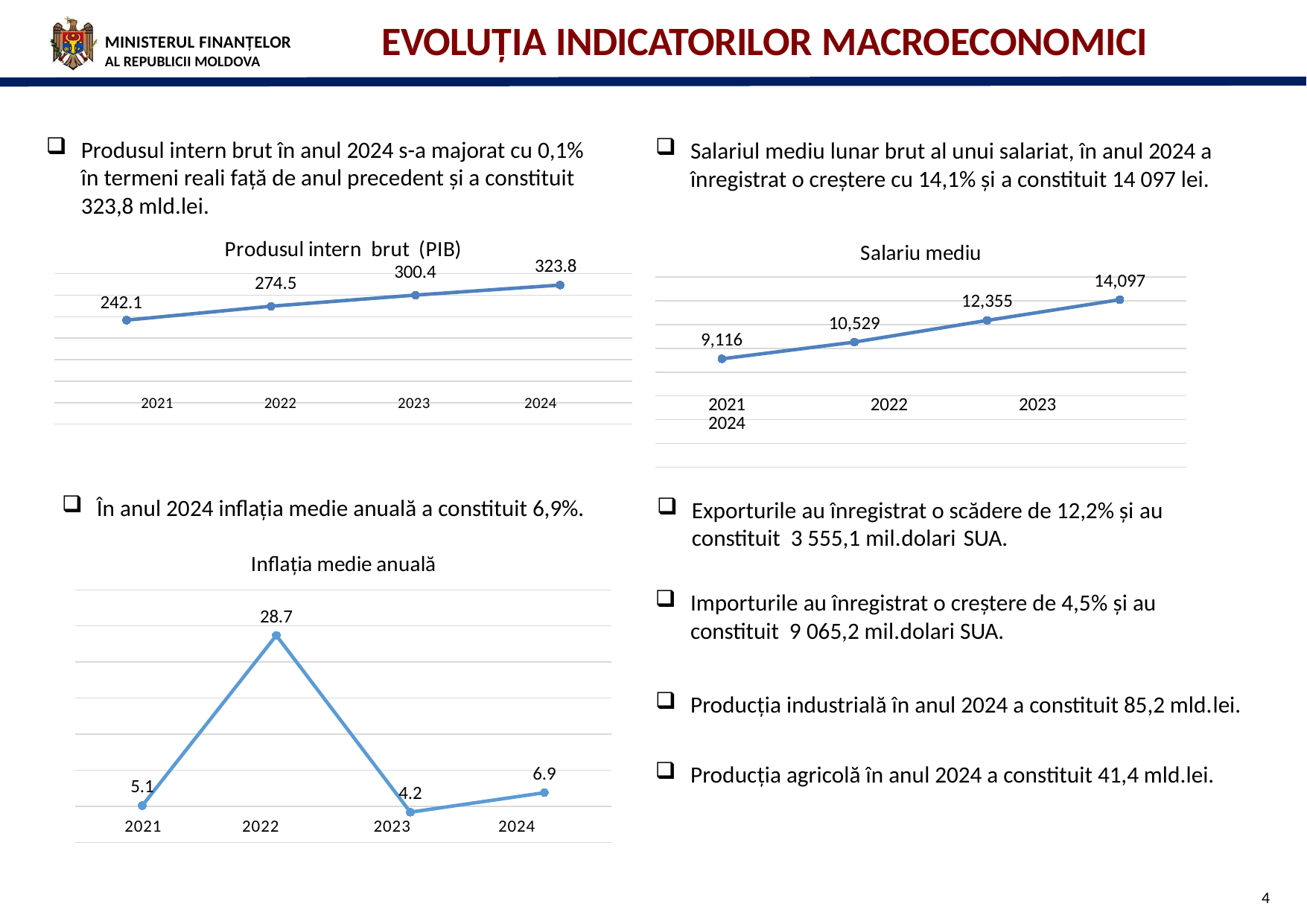
In the 'Produsul intern brut (PIB)' chart, what is the value for 2021? 242.1 In the 'Produsul intern brut (PIB)' chart, what is the difference between the 2023 and 2022 values? 25.9 In the 'Salariu mediu' chart, which year has the highest value? 2024 How many data points are plotted in the 'Inflația medie anuală' chart? 4 In the 'Produsul intern brut (PIB)' chart, do the values rise or fall from 2021 to 2024? rise In the 'Produsul intern brut (PIB)' chart, what is the value for 2024? 323.8 What type of chart is the 'Salariu mediu' chart? line chart In the 'Inflația medie anuală' chart, which is larger, the value for 2021 or the value for 2024? 2024 In the 'Inflația medie anuală' chart, which year has the lowest value? 2023 In the 'Salariu mediu' chart, what is the difference between the 2024 and 2023 values? 1,742 In the 'Inflația medie anuală' chart, what is the value for 2022? 28.7 In the 'Salariu mediu' chart, what is the value for 2022? 10,529